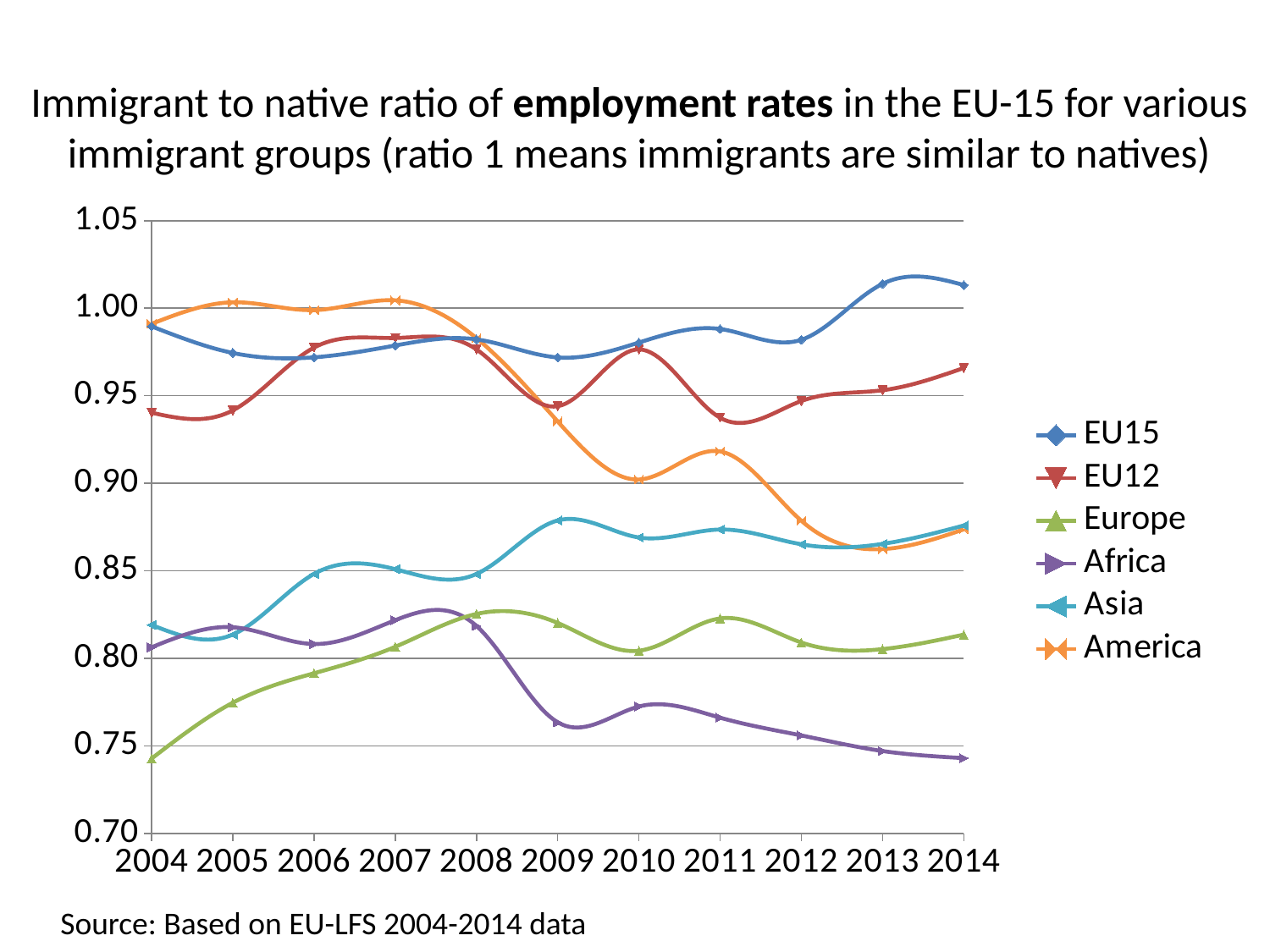
Does the Africa series rise or fall from 2008 to 2014? fall Is the value for Africa in 2009 greater or less than 0.80? less Is the value for EU15 in 2013 greater or less than 1.00? greater What source is cited below the chart? Based on EU-LFS 2004-2014 data Is the value for America in 2010 greater or less than 0.95? less Which series has the lowest value in 2014? Africa Which series has the lowest value in 2004? Europe How many years are plotted along the x axis? 11 Which series has the highest value in 2014? EU15 What kind of chart is shown on the slide? line chart In 2012, which is higher: Asia or Europe? Asia How many series does the legend list? 6